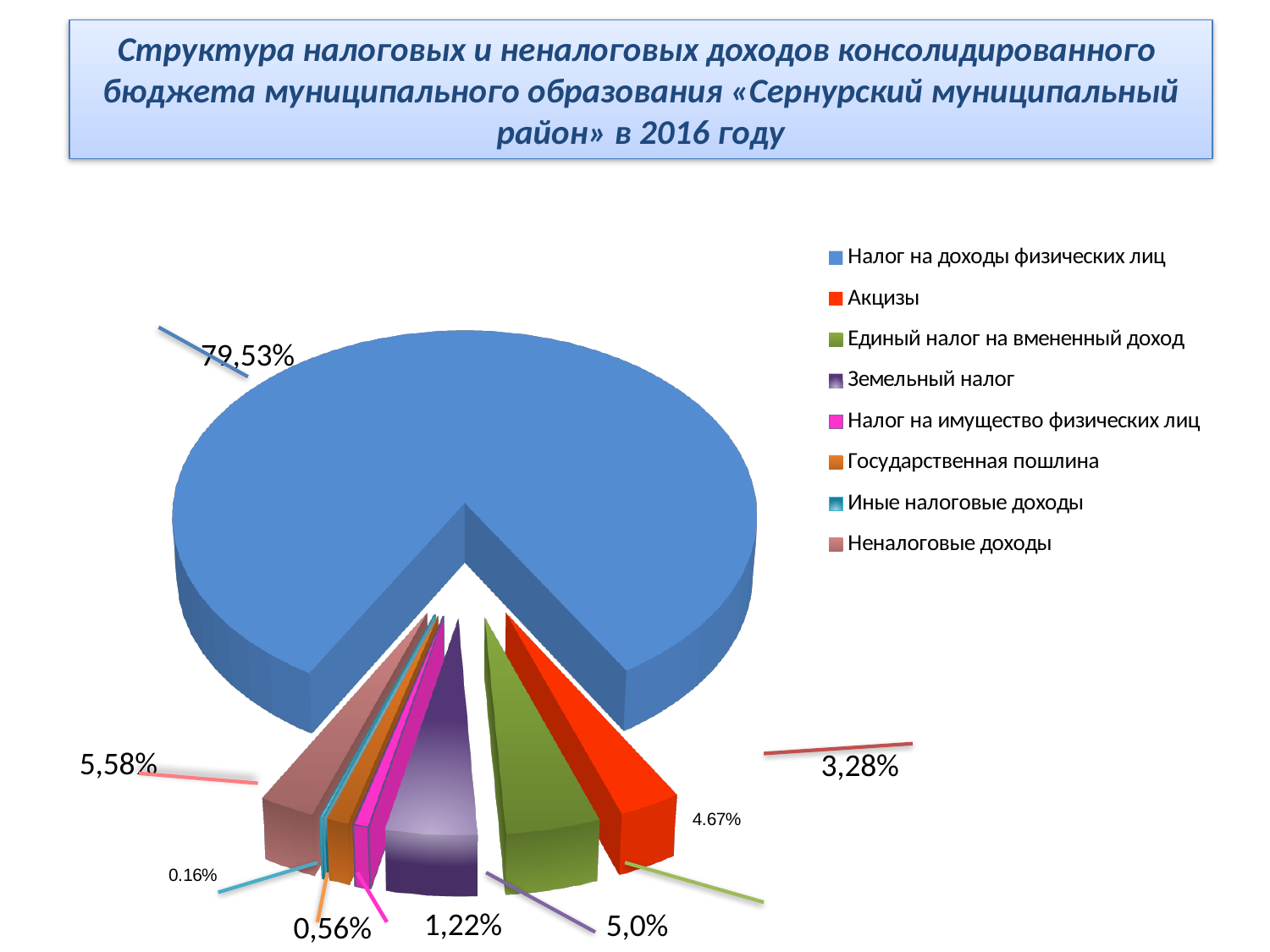
What is the difference between the share for Налог на доходы физических лиц (79,53%) and the share for Единый налог на вмененный доход (5,0%)? 74,53% What share is labelled for Неналоговые доходы? 5,58% What is the share shown for the largest slice of the pie? 79,53% What is the smallest percentage label shown on the pie chart? 0.16% Which category has the largest share of the pie? Налог на доходы физических лиц Which year does the chart title say the data refers to? 2016 Is the share for Налог на доходы физических лиц greater or less than 50%? greater What share is labelled for Земельный налог? 1,22% What kind of chart is shown on the slide? pie chart How many categories does the legend of the pie chart list? 8 What share is labelled for Единый налог на вмененный доход? 5,0%